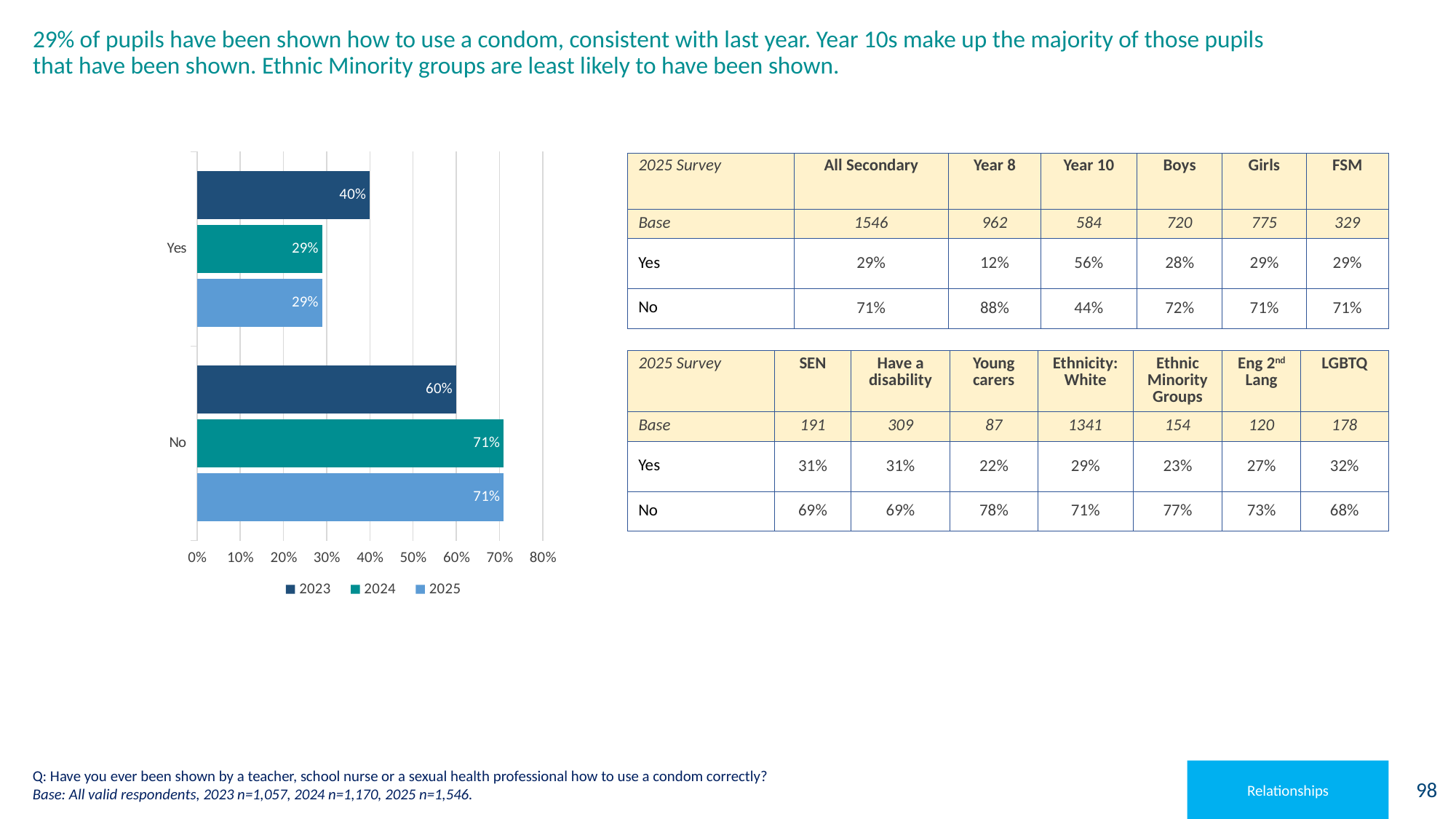
What is the value for 'No' in the 2023 series? 60% What kind of chart is shown on the slide? Bar chart Which series has the lowest value for 'Yes'? 2024 and 2025 (both 29%) Which series has the highest value for 'No'? 2024 and 2025 (both 71%) Which is larger: the 2023 value for 'Yes' or the 2024 value for 'Yes'? 2023 How many categories are shown on the chart? 2 What is the value for 'Yes' in the 2023 series? 40% What is the difference between the 2024 and 2023 values for 'No'? 11 percentage points How many series does the legend list? 3 What is the value for 'No' in the 2025 series? 71% What is the difference between the 2023 and 2025 values for 'Yes'? 11 percentage points What is the value for 'Yes' in the 2024 series? 29%